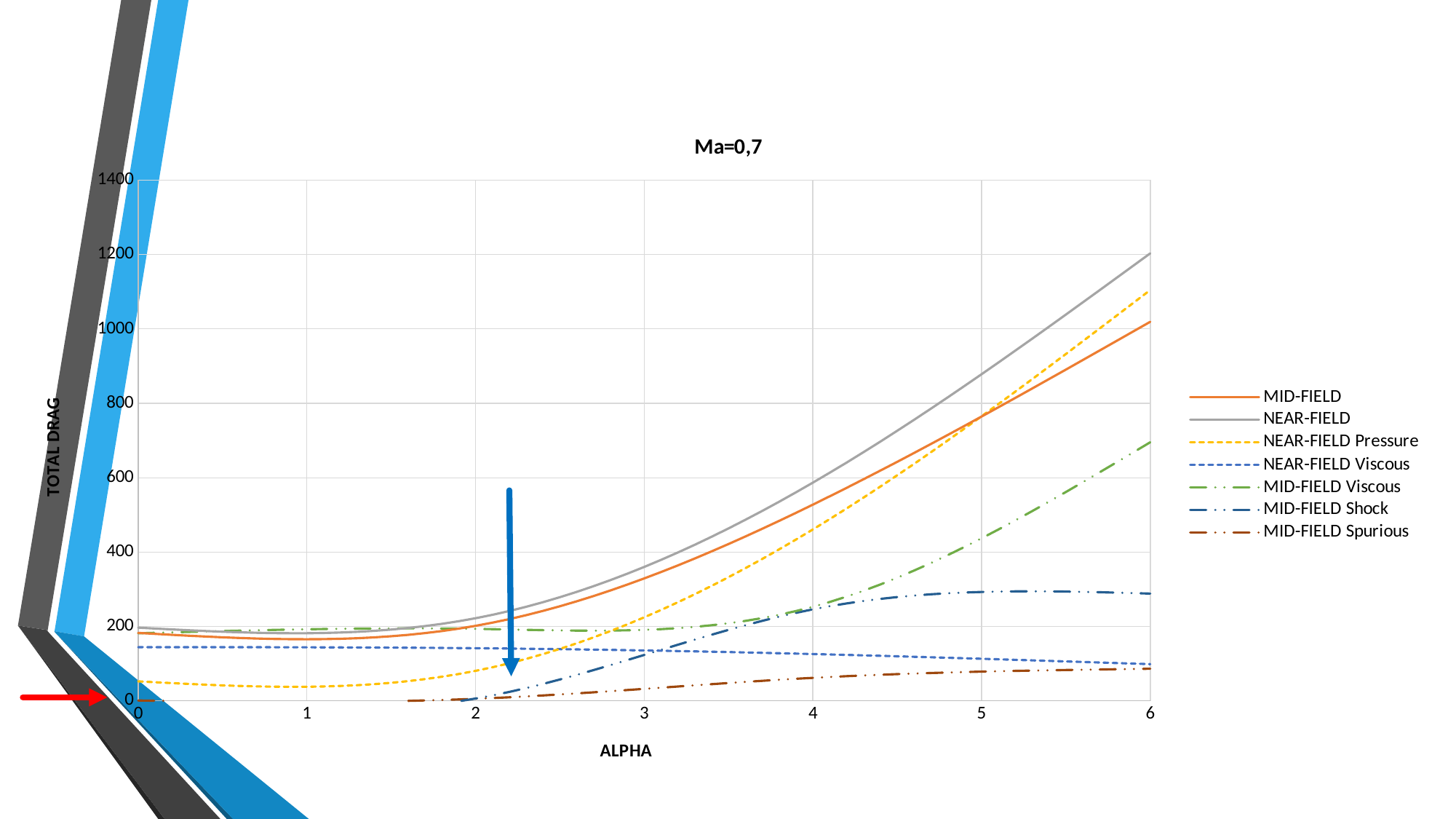
Is the MID-FIELD Shock value at ALPHA = 6 greater or less than 400? less How many series does the legend list? 7 Does the NEAR-FIELD Pressure series rise or fall as ALPHA increases from 2 to 6? rise Which series has the highest value at ALPHA = 6? NEAR-FIELD At ALPHA = 6, which is larger: MID-FIELD Viscous or NEAR-FIELD Viscous? MID-FIELD Viscous Does the NEAR-FIELD Viscous series rise or fall as ALPHA increases from 3 to 6? fall At ALPHA = 6, which is larger: MID-FIELD or NEAR-FIELD Pressure? NEAR-FIELD Pressure What kind of chart is shown on the slide? line chart Is the NEAR-FIELD value at ALPHA = 6 greater or less than 1000? greater Is the MID-FIELD Spurious value at ALPHA = 6 greater or less than 200? less What is the title of the chart? Ma=0,7 What is the label of the x axis? ALPHA